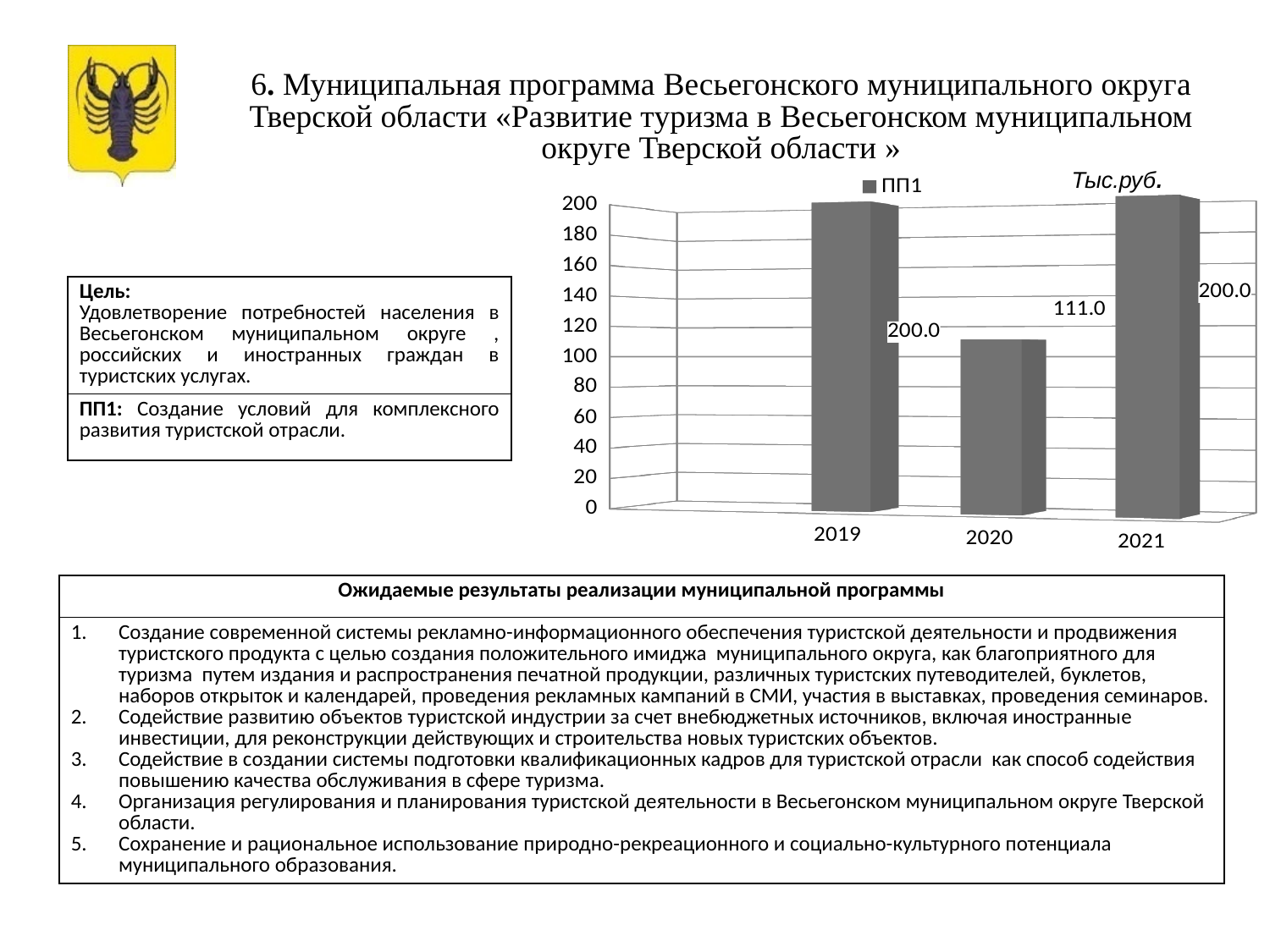
What is the value for 2020 in the ПП1 chart? 111.0 What unit is indicated above the chart? Тыс.руб. How many series does the chart legend list? 1 What is the value for 2019 in the ПП1 chart? 200.0 What kind of chart is shown on the slide? bar chart What is the difference between the values for 2019 and 2020? 89.0 Which year has the lowest value in the chart? 2020 Does the value fall or rise from 2020 to 2021? rise Which is larger, the value for 2020 or the value for 2021? 2021 What is the value for 2021 in the ПП1 chart? 200.0 How many years are shown on the x axis of the chart? 3 Is the value for 2020 greater or less than 120? less